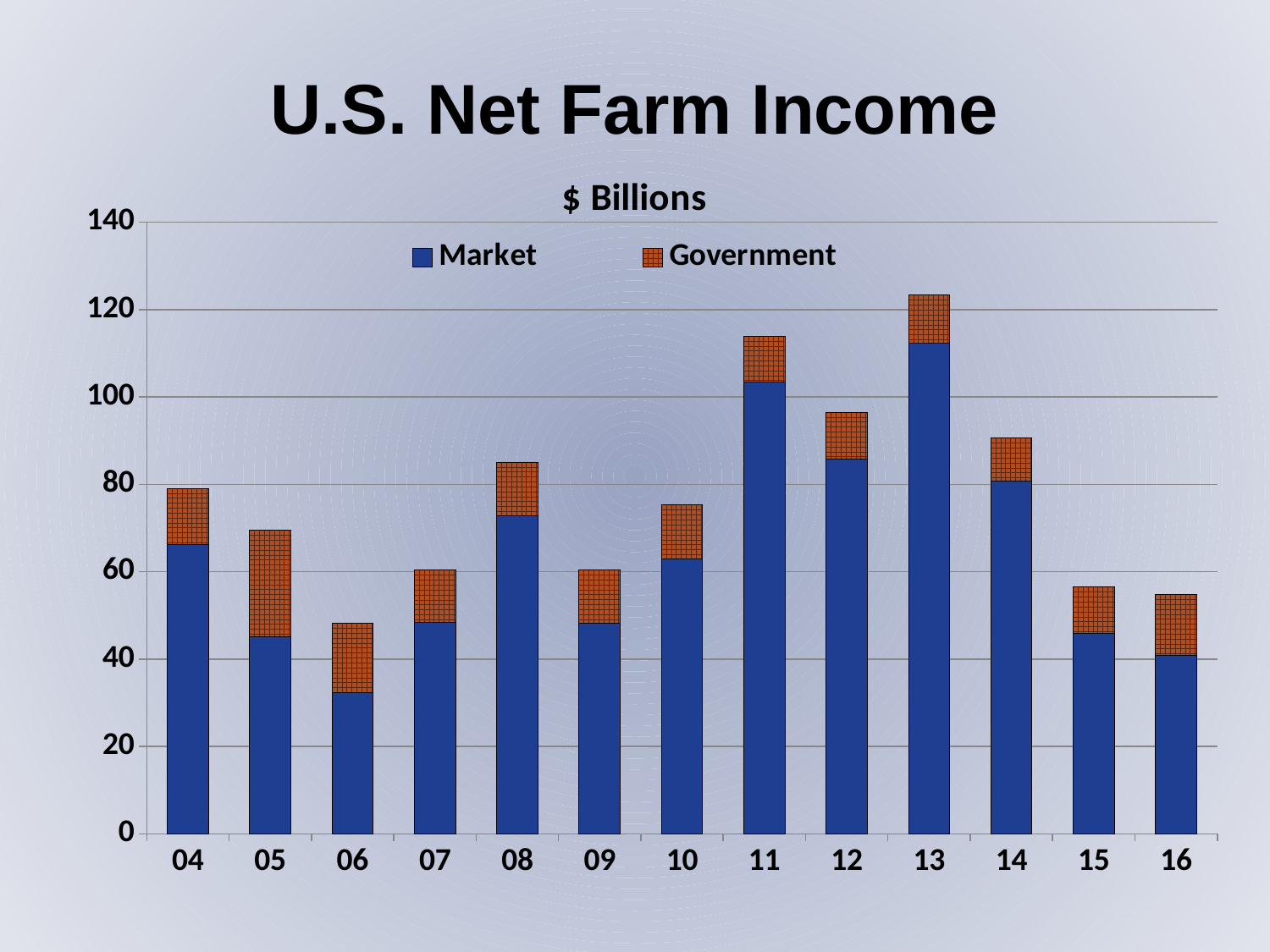
Is the total value for 06 greater or less than 60? less Is the total value for 11 greater or less than 100? greater What kind of chart is shown on the slide? stacked bar chart Which year has the lowest total net farm income? 06 Do the total values rise or fall from 13 to 16? fall Which year has the larger total, 11 or 12? 11 Is the Market value for 13 greater or less than 100? greater How many years are shown on the x axis? 13 What unit is given for the values in the chart? $ Billions Which year has the highest total net farm income? 13 Which year has the lowest Market value? 06 How many series does the legend list? 2